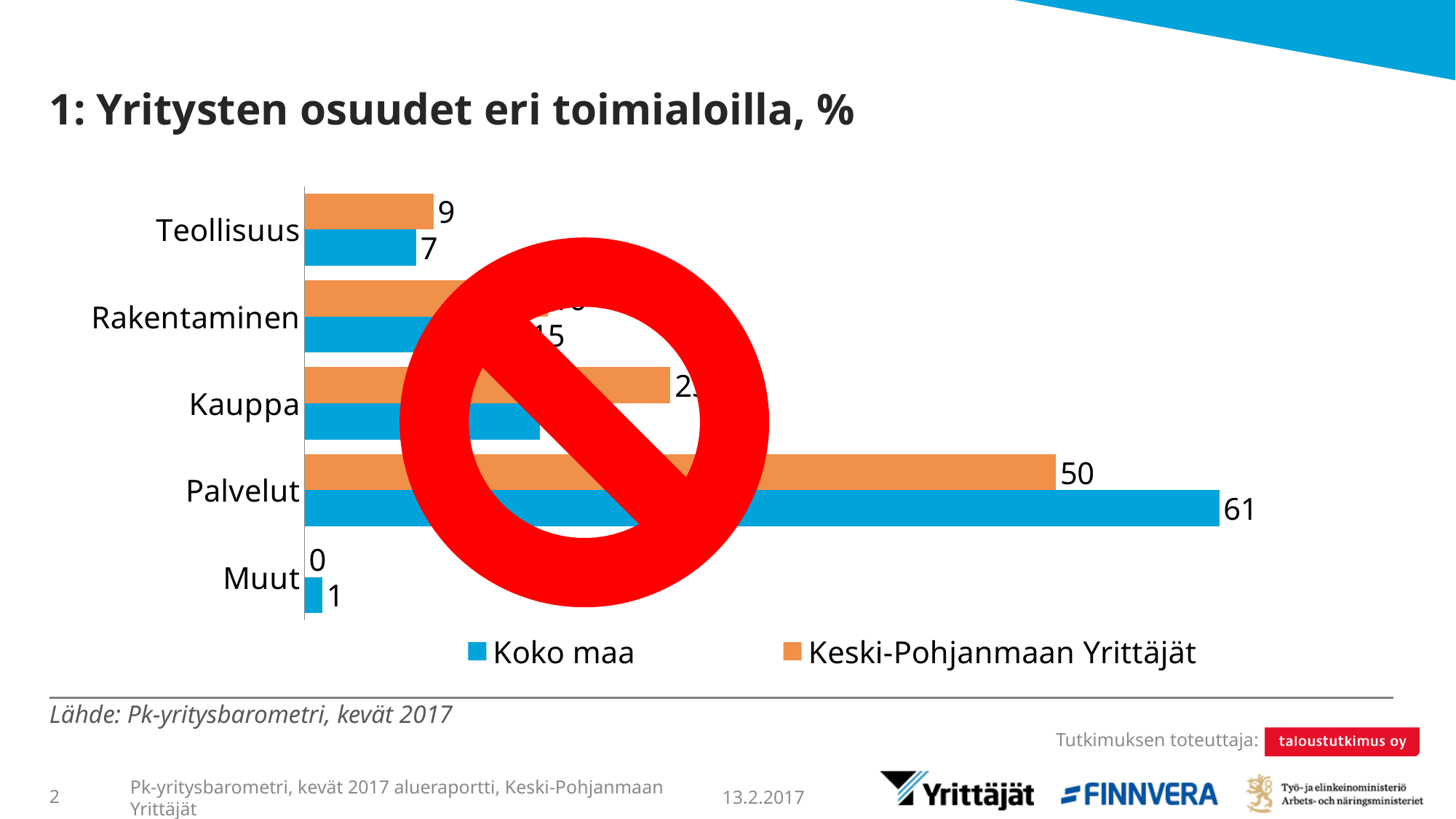
What is the difference between the Koko maa and Keski-Pohjanmaan Yrittäjät values for Palvelut? 11 How many categories are shown on the chart? 5 How many series does the legend list? 2 What is the value for Keski-Pohjanmaan Yrittäjät in the Palvelut category? 50 Which category has the highest value for Koko maa? Palvelut What is the value for Koko maa in the Teollisuus category? 7 What is the value for Koko maa in the Palvelut category? 61 What is the value for Koko maa in the Muut category? 1 What is the value for Keski-Pohjanmaan Yrittäjät in the Teollisuus category? 9 Which category has the lowest value for Keski-Pohjanmaan Yrittäjät? Muut In the Teollisuus category, which series has the larger value, Koko maa or Keski-Pohjanmaan Yrittäjät? Keski-Pohjanmaan Yrittäjät What is the value for Keski-Pohjanmaan Yrittäjät in the Muut category? 0